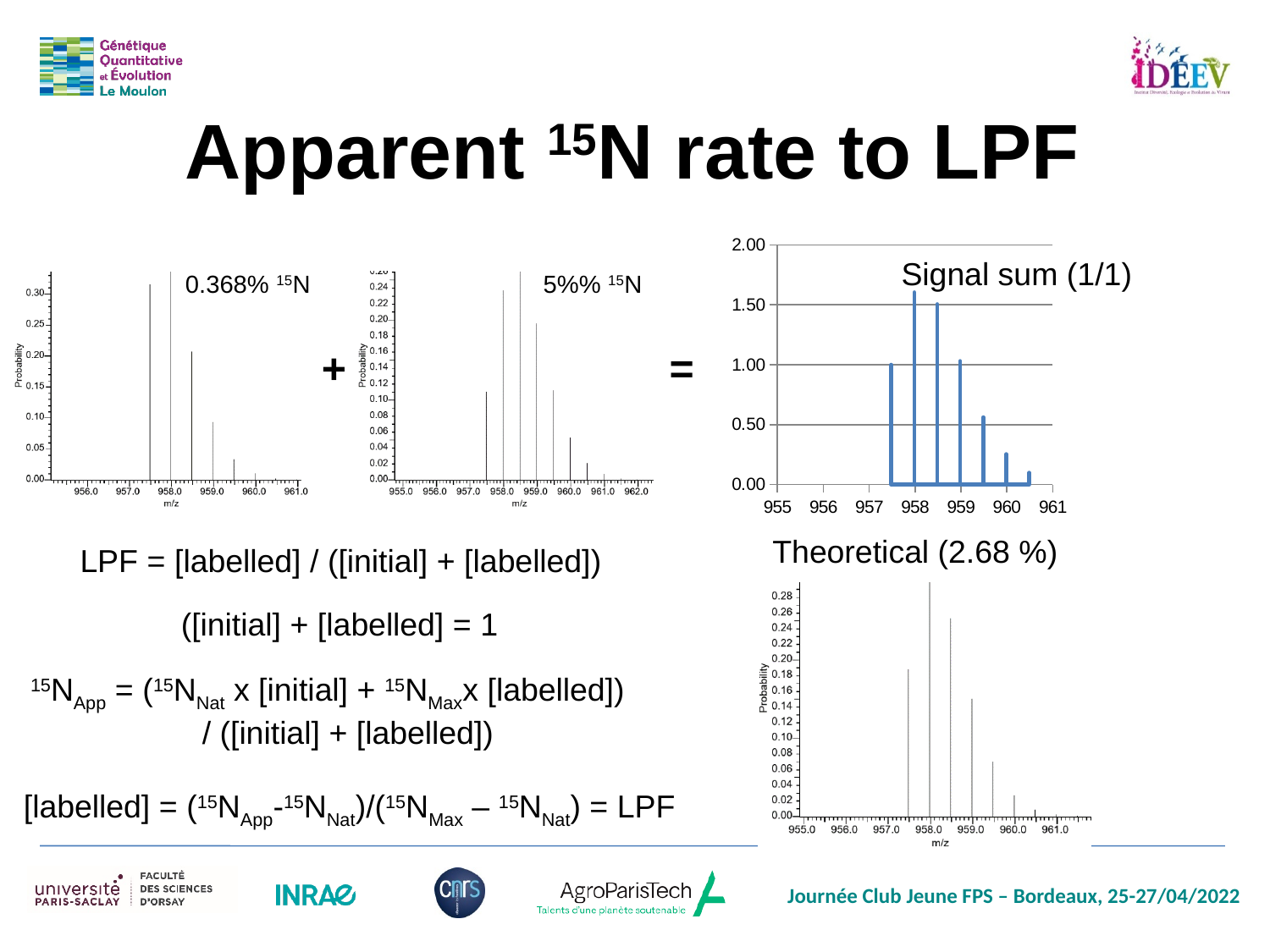
In the 'Signal sum (1/1)' chart, is the bar at m/z 958 taller or shorter than the bar at m/z 959? taller In the 'Signal sum (1/1)' chart, how many bars are plotted? 7 In the '0.368% 15N' chart on the left, is the probability of the peak at m/z 958.0 greater or less than 0.15? greater What kind of chart is the 'Signal sum (1/1)' chart? bar chart In the 'Signal sum (1/1)' chart, is the value of the bar at m/z 960 greater or less than 0.50? less What is the highest value shown on the y axis of the 'Signal sum (1/1)' chart? 2.00 In the 'Theoretical (2.68 %)' chart, is the probability of the peak at m/z 958.5 greater or less than 0.20? greater What is the title of the bar chart in the upper right of the slide? Signal sum (1/1) In the 'Signal sum (1/1)' chart, at which m/z value is the tallest bar? 958 In the 'Signal sum (1/1)' chart, do the bar values rise or fall as m/z increases from 958 to 960.5? fall